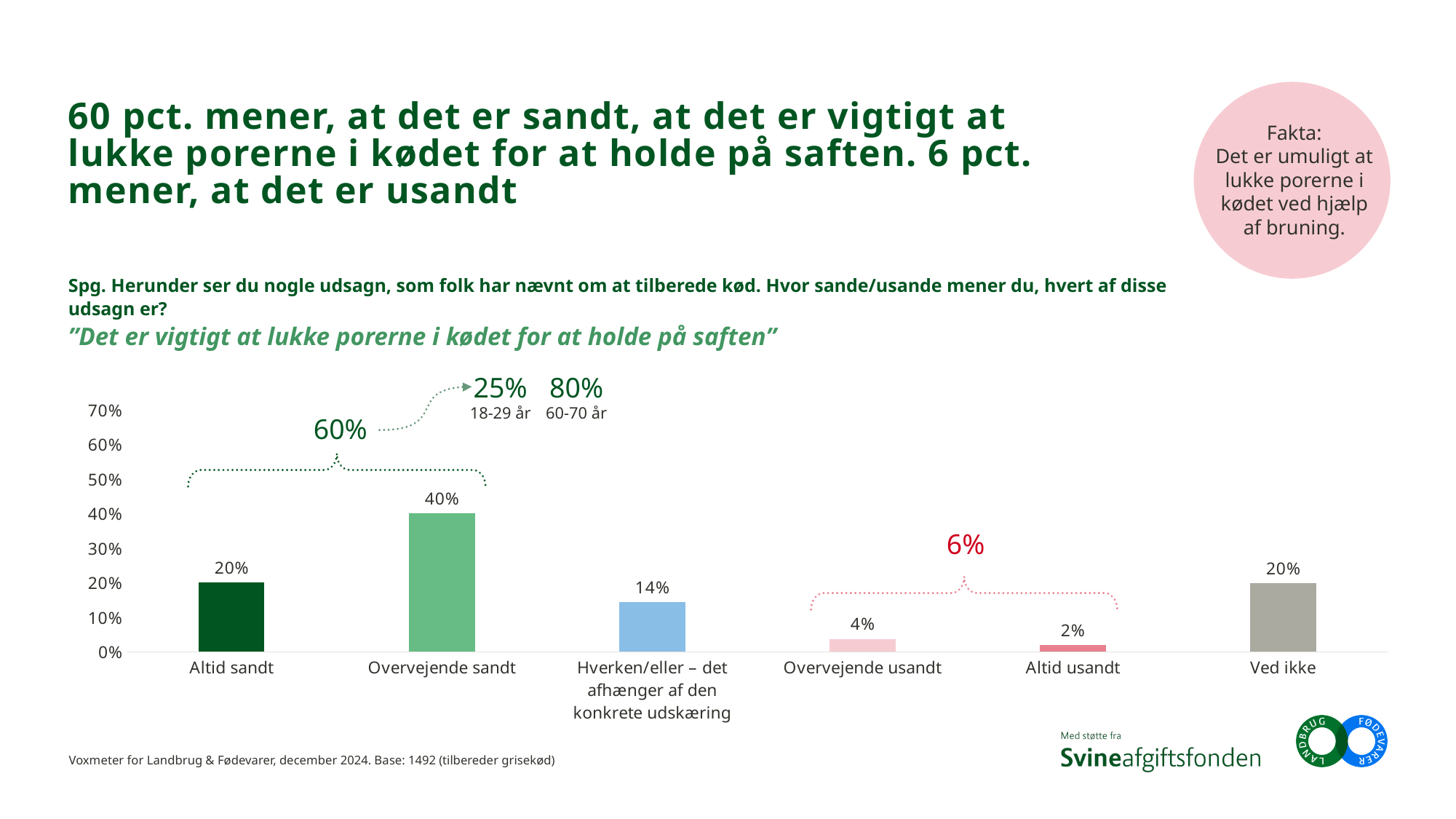
What is the value for "Overvejende sandt"? 40% What kind of chart is shown on the slide? Bar chart What is the difference between the values for "Overvejende sandt" and "Altid sandt"? 20% According to the annotation, what share of 60-70 år respondents think the statement is true? 80% What is the value for "Hverken/eller – det afhænger af den konkrete udskæring"? 14% How many categories are shown on the x axis? 6 What is the combined share shown for "Overvejende usandt" and "Altid usandt" according to the annotation? 6% Is the value for "Overvejende sandt" greater or less than 30%? greater What is the value for "Altid usandt"? 2% Which category has the highest value? Overvejende sandt Which is larger, the value for "Ved ikke" or the value for "Hverken/eller – det afhænger af den konkrete udskæring"? Ved ikke Which category has the lowest value? Altid usandt